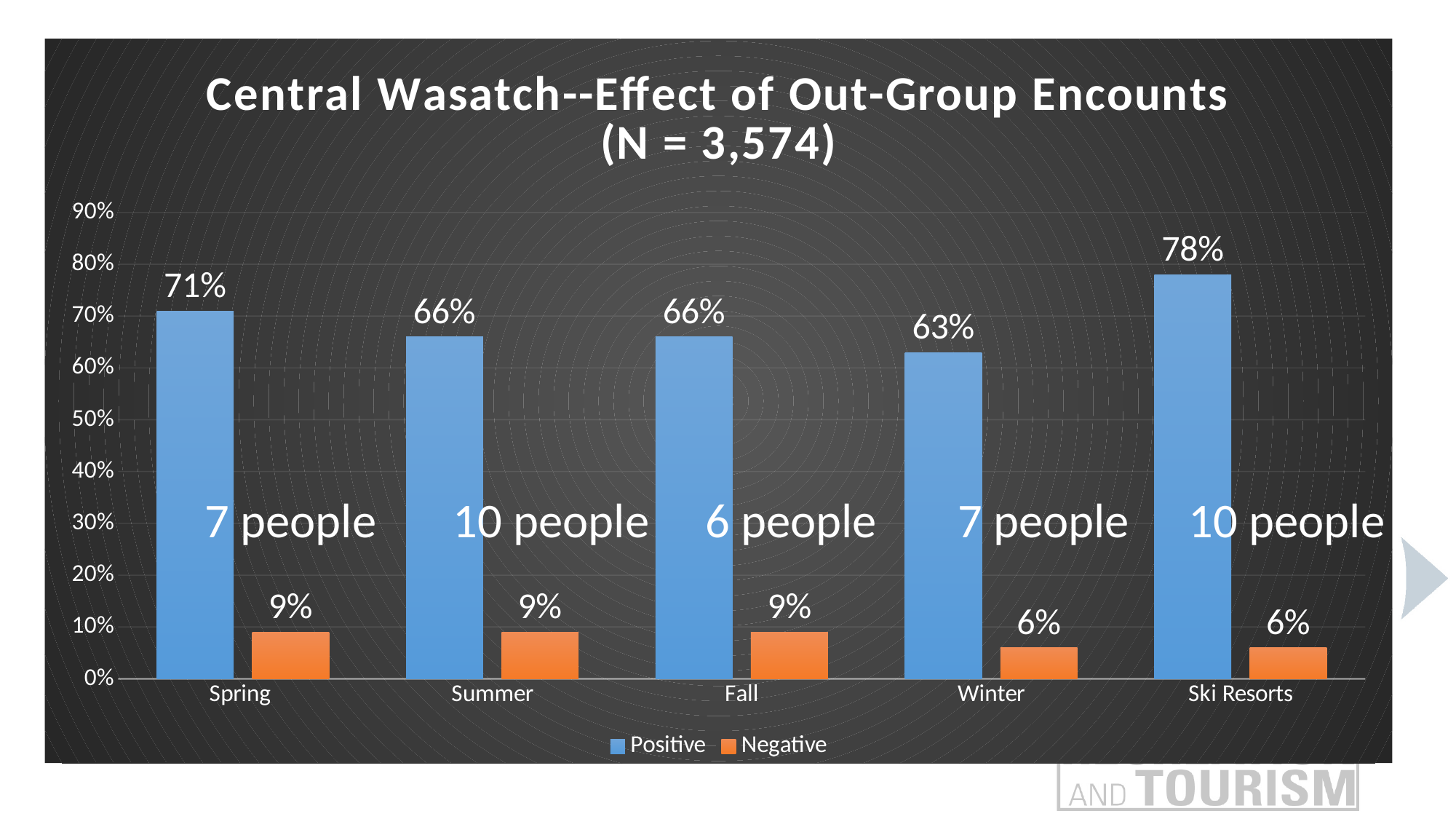
How many categories are shown on the x axis? 5 What kind of chart is shown on the slide? bar chart What is the sample size (N) given in the chart title? 3,574 What is the Positive value for Ski Resorts? 78% Which category has the lowest Positive value? Winter What is the difference between the Positive values for Ski Resorts and Winter? 15% What is the Positive value for Spring? 71% What is the Negative value for Winter? 6% Which category has the highest Positive value? Ski Resorts Is the Positive value for Fall greater or less than 60%? greater How many series does the legend list? 2 Which is larger, the Positive value for Spring or the Positive value for Summer? Spring